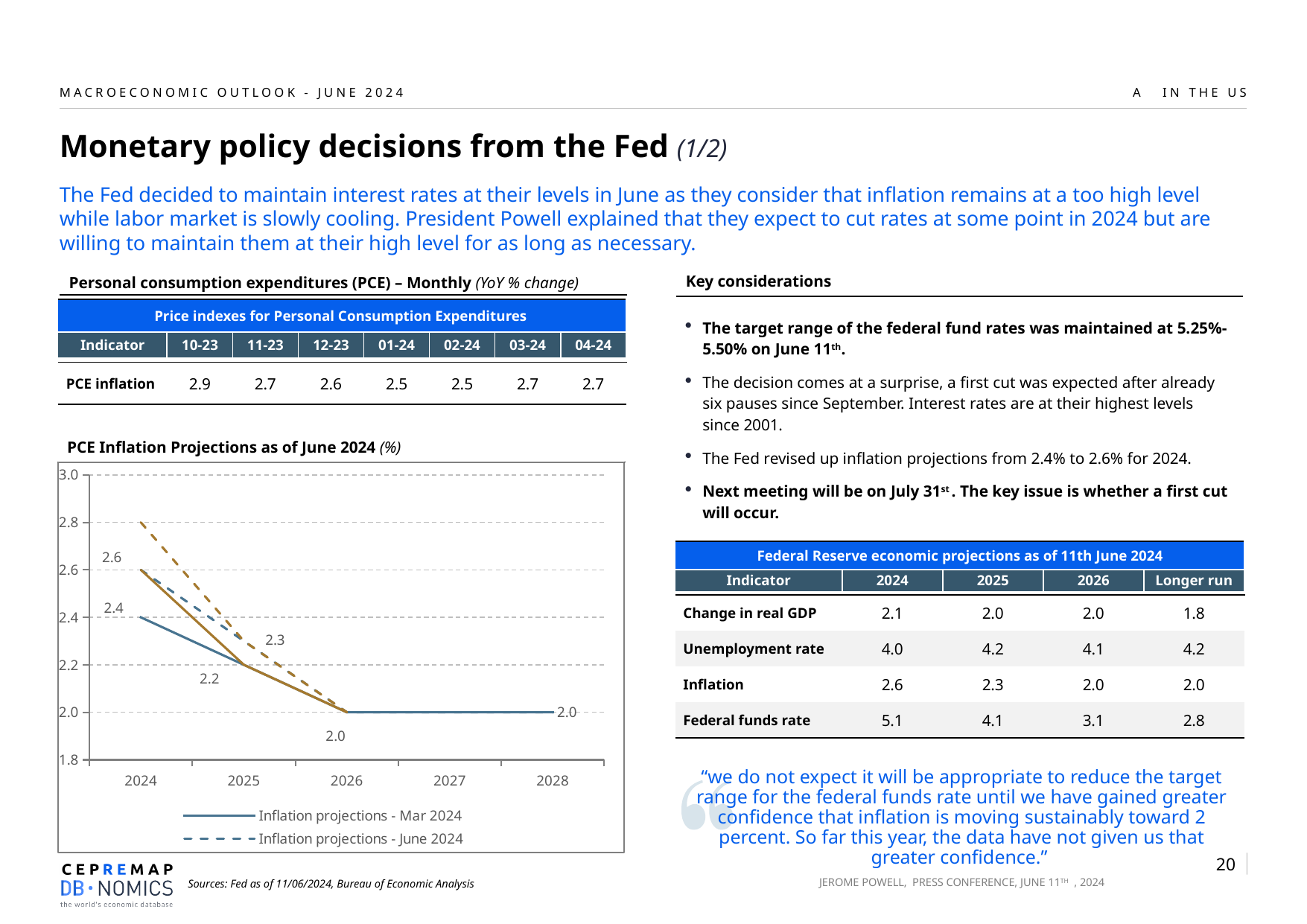
In the PCE Inflation Projections chart, do the projected values rise or fall from 2024 to 2026? fall What kind of chart is the PCE Inflation Projections as of June 2024 chart? line chart In the PCE Inflation Projections chart, which projection for 2025 is higher, Mar 2024 or June 2024? June 2024 In the PCE Inflation Projections chart, what is the June 2024 inflation projection for 2024? 2.6 In the PCE Inflation Projections chart, what is the June 2024 inflation projection for 2025? 2.3 In the PCE Inflation Projections chart, what is the Mar 2024 inflation projection for 2024? 2.4 How many years are shown on the x axis of the PCE Inflation Projections chart? 5 In the PCE Inflation Projections chart, what is the Mar 2024 inflation projection for 2025? 2.2 How many series does the legend of the PCE Inflation Projections chart list? 2 In the PCE Inflation Projections chart, what is the inflation projection for 2028? 2.0 What is the title of the line chart on the slide? PCE Inflation Projections as of June 2024 (%) In the PCE Inflation Projections chart, what is the difference between the June 2024 and Mar 2024 projections for 2024? 0.2